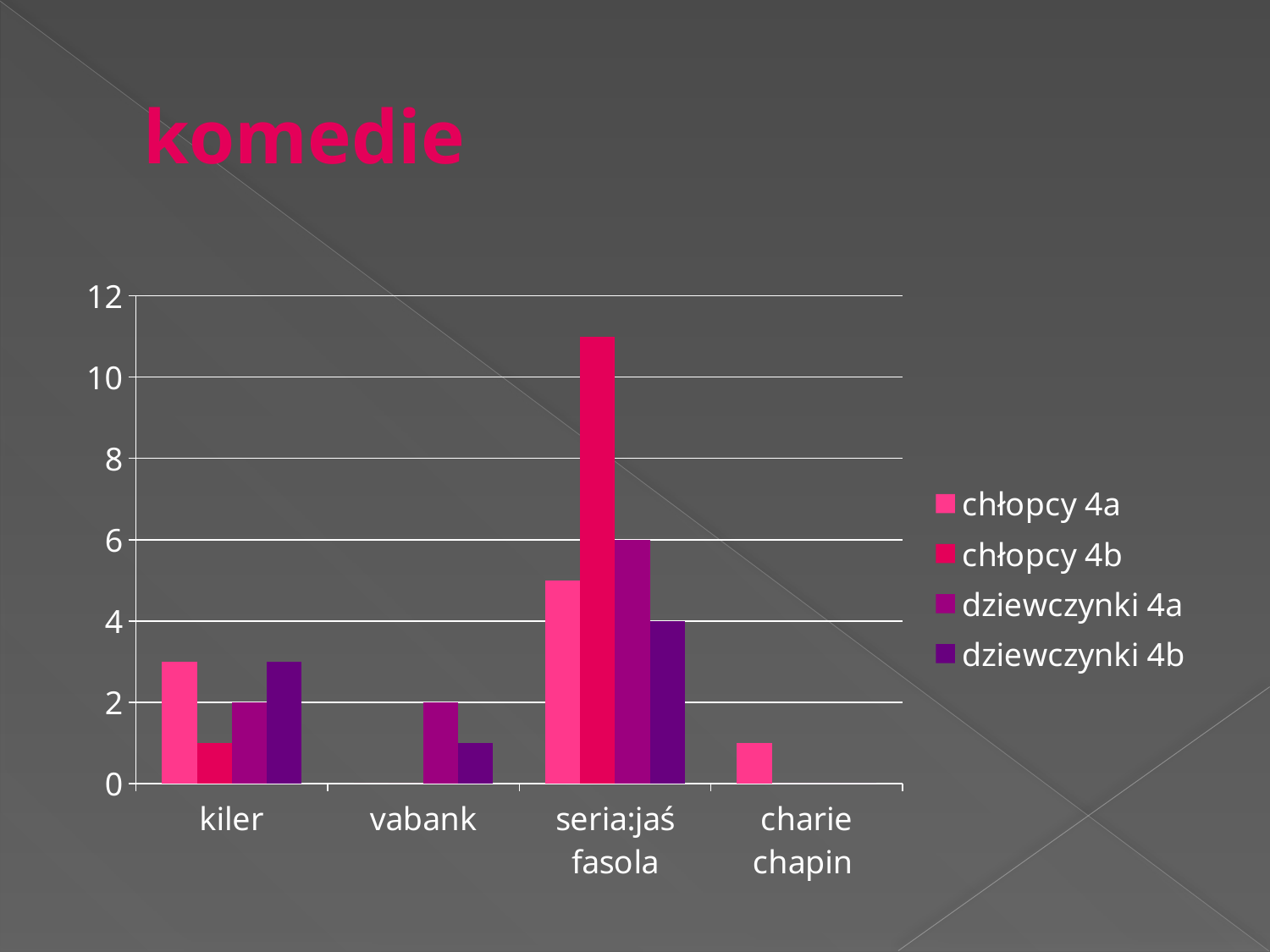
What is the title of the chart? komedie What is the value for dziewczynki 4a in the kiler category? 2 Is the value for chłopcy 4a in the charie chapin category greater or less than 2? less What is the difference between dziewczynki 4a and dziewczynki 4b in the seria:jaś fasola category? 2 What kind of chart is shown on the slide? bar chart Is the value for chłopcy 4b in the seria:jaś fasola category greater or less than 10? greater Which is larger in the seria:jaś fasola category: chłopcy 4b or dziewczynki 4a? chłopcy 4b What is the value for dziewczynki 4a in the seria:jaś fasola category? 6 How many series does the legend list? 4 What is the value for dziewczynki 4b in the seria:jaś fasola category? 4 How many categories are shown on the x axis? 4 Which category has the highest value for chłopcy 4b? seria:jaś fasola